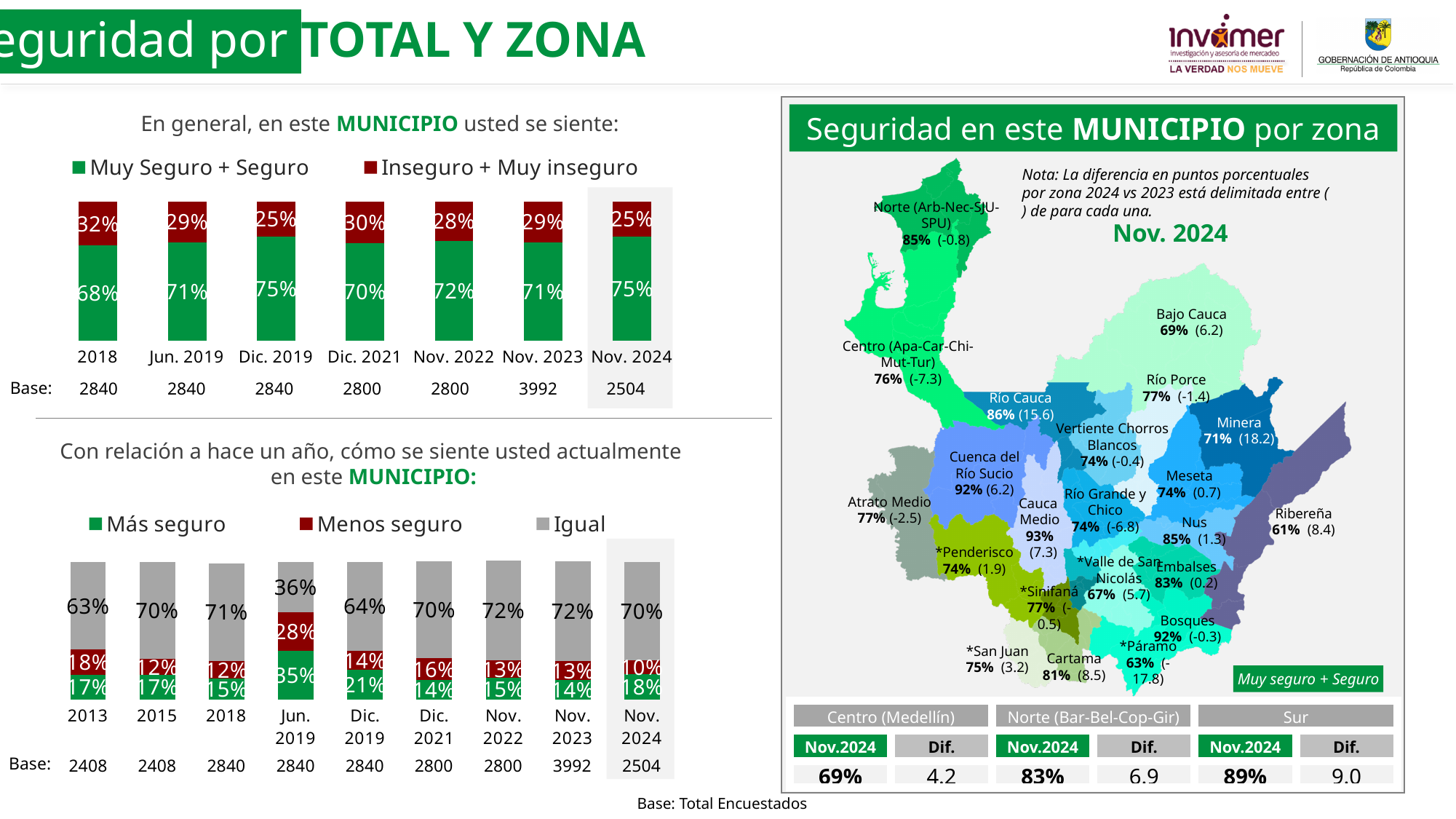
In the bottom chart 'Con relación a hace un año', what is the value of 'Igual' for Jun. 2019? 36% What type of chart is the bottom chart 'Con relación a hace un año'? Stacked bar chart In the top chart 'En general, en este MUNICIPIO usted se siente', how many series does the legend list? 2 In the top chart 'En general, en este MUNICIPIO usted se siente', how many periods are shown on the x axis? 7 In the bottom chart 'Con relación a hace un año', how many series does the legend list? 3 In the top chart 'En general, en este MUNICIPIO usted se siente', what is the value of 'Muy Seguro + Seguro' for Nov. 2024? 75% In the bottom chart 'Con relación a hace un año', is 'Más seguro' or 'Menos seguro' larger for Nov. 2024? Más seguro In the bottom chart 'Con relación a hace un año', which period has the highest 'Más seguro' value? Jun. 2019 In the top chart 'En general, en este MUNICIPIO usted se siente', what is the difference in 'Muy Seguro + Seguro' between Nov. 2024 and Nov. 2023? 4 percentage points In the bottom chart 'Con relación a hace un año', what is the value of 'Menos seguro' for Nov. 2024? 10% In the top chart 'En general, en este MUNICIPIO usted se siente', which period has the lowest 'Muy Seguro + Seguro' value? 2018 In the top chart 'En general, en este MUNICIPIO usted se siente', what is the value of 'Inseguro + Muy inseguro' for 2018? 32%